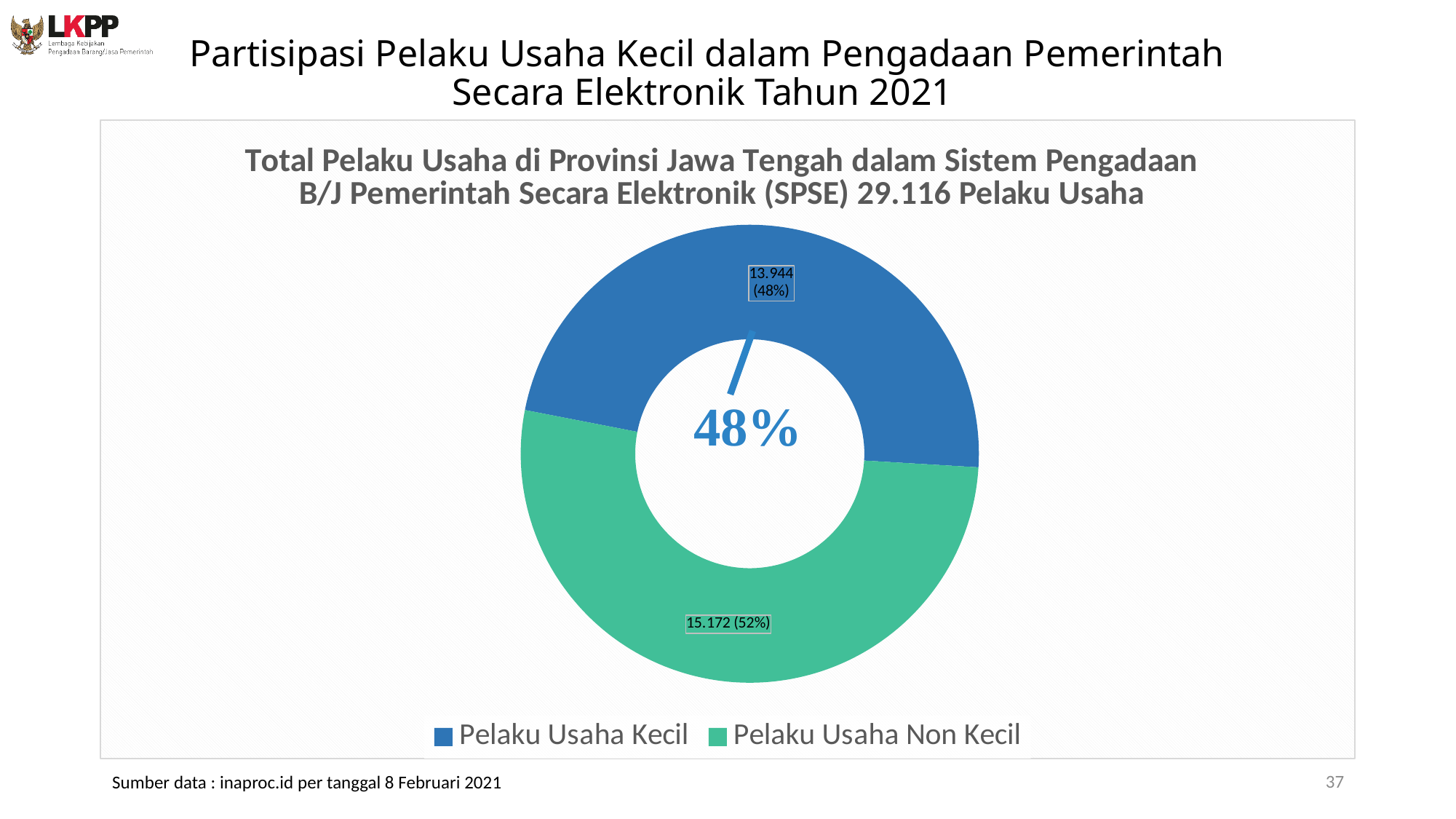
Which category has the largest value? Pelaku Usaha Non Kecil What colour is the Pelaku Usaha Non Kecil slice? Green What is the difference between the values for Pelaku Usaha Non Kecil and Pelaku Usaha Kecil? 1.228 What total number of Pelaku Usaha is stated in the chart title? 29.116 What is the value for Pelaku Usaha Kecil? 13.944 Which category has the smallest value? Pelaku Usaha Kecil What kind of chart is shown on the slide? Doughnut (pie) chart What share of the chart does Pelaku Usaha Non Kecil represent? 52% What is the value for Pelaku Usaha Non Kecil? 15.172 Which is larger, Pelaku Usaha Kecil or Pelaku Usaha Non Kecil? Pelaku Usaha Non Kecil How many categories does the chart show? 2 What share of the chart does Pelaku Usaha Kecil represent? 48%